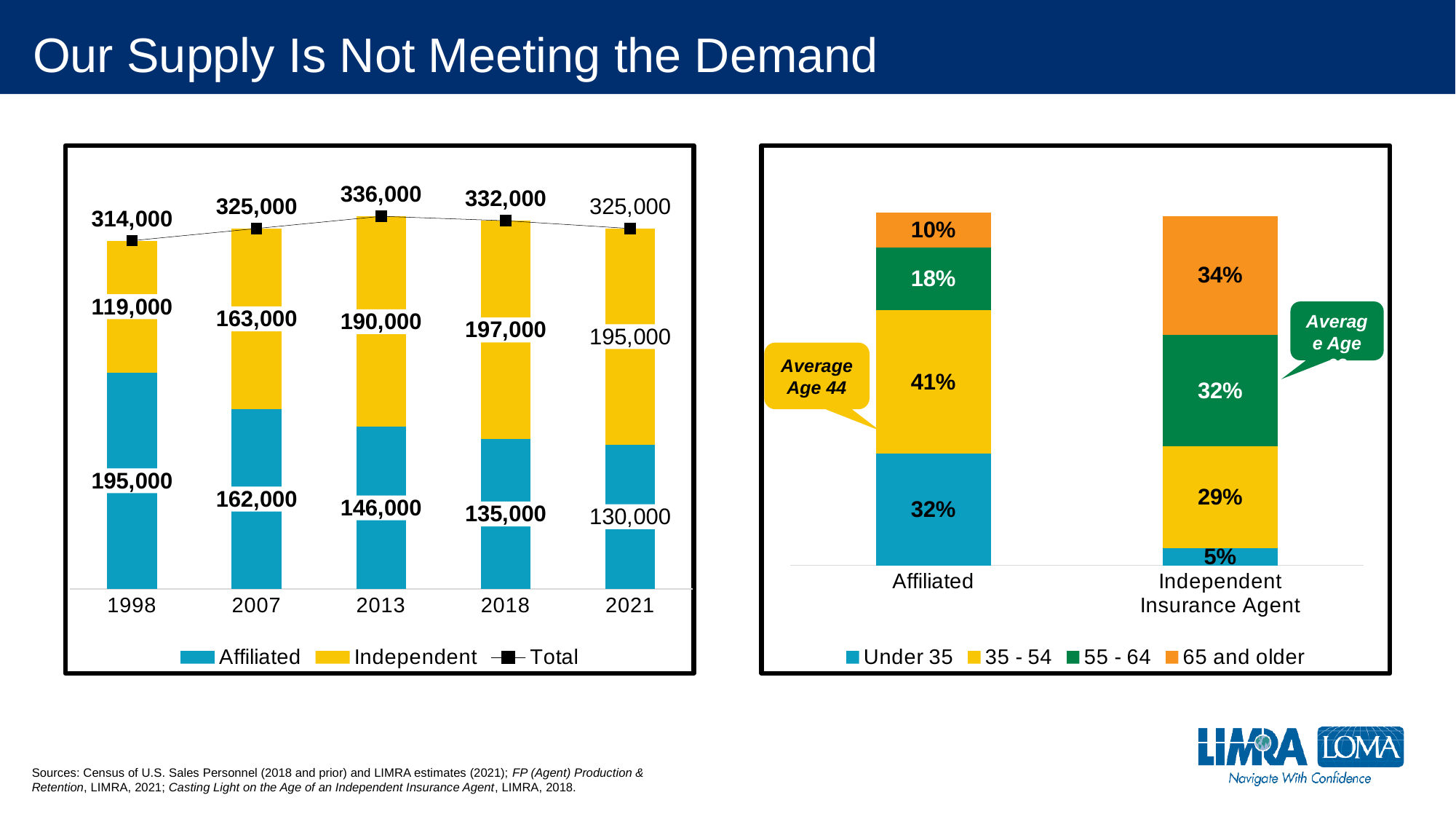
In the right chart, what share of Independent Insurance Agents are 65 and older? 34% In the left chart, what is the difference between the Independent and Affiliated values in 2021? 65,000 In the left chart, does the Affiliated value rise or fall from 1998 to 2021? Fall In the right chart, what is the difference between the Under 35 shares for Affiliated and Independent Insurance Agent? 27% In the left chart, which year has the highest Total? 2013 In the left chart, how many years are shown on the x axis? 5 In the left chart, what is the Independent value for 2018? 197,000 In the left chart, which year has the lowest Affiliated value? 2021 In the left chart, what is the Affiliated value for 1998? 195,000 What kind of chart is the right chart? Stacked bar chart In the left chart, how many series does the legend list? 3 In the left chart, is the Affiliated value or the Independent value larger in 2007? Independent